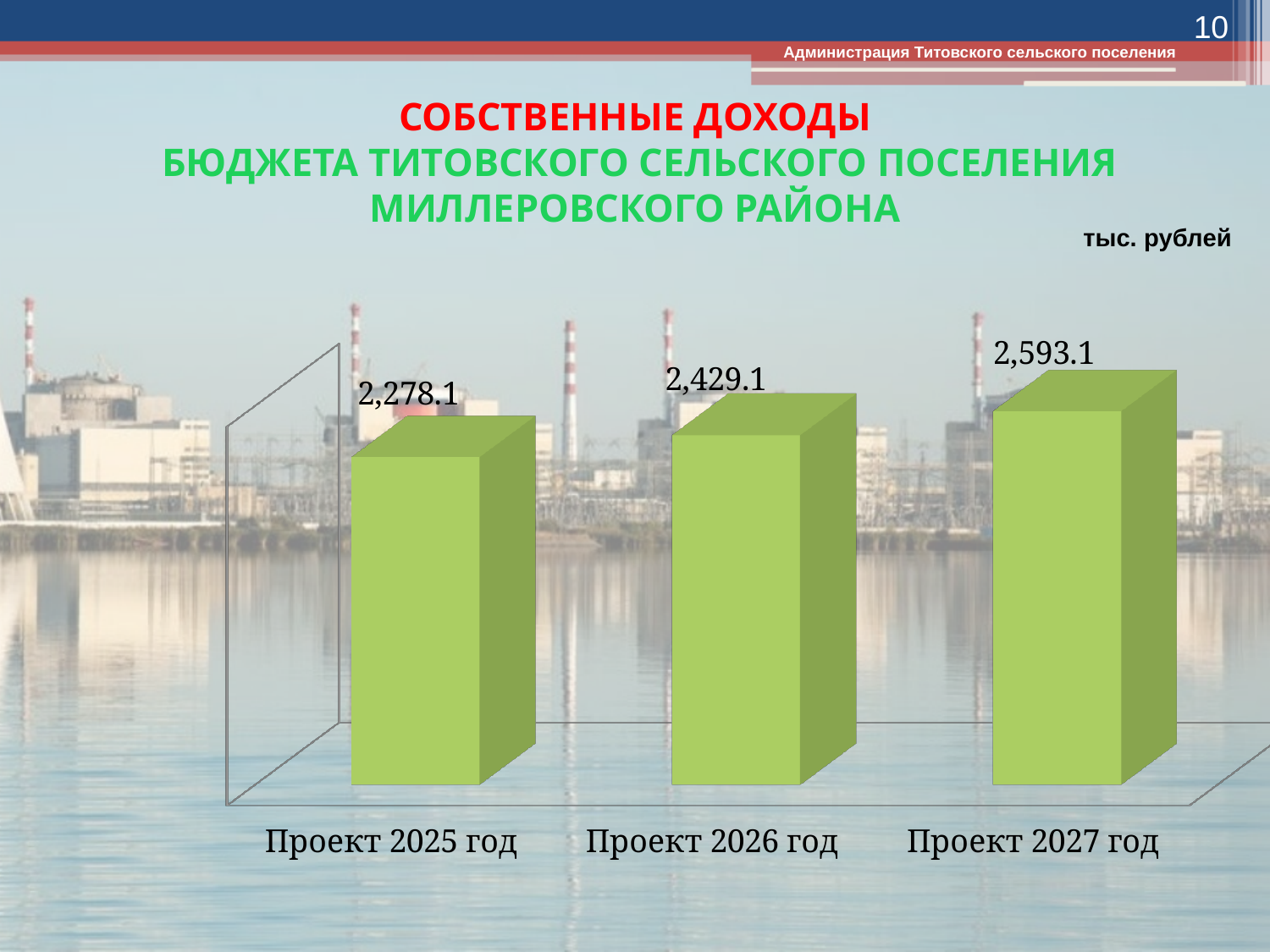
How many categories are shown in the chart? 3 What is the difference between the values for Проект 2026 год and Проект 2025 год? 151.0 Which category has the highest value? Проект 2027 год What is the value for Проект 2026 год? 2,429.1 What is the value for Проект 2027 год? 2,593.1 What is the difference between the values for Проект 2027 год and Проект 2025 год? 315.0 Which category has the lowest value? Проект 2025 год What kind of chart is shown on the slide? Bar chart What is the value for Проект 2025 год? 2,278.1 Do the values rise or fall from Проект 2025 год to Проект 2027 год? Rise What is the difference between the values for Проект 2027 год and Проект 2026 год? 164.0 Which is larger, the value for Проект 2026 год or Проект 2027 год? Проект 2027 год